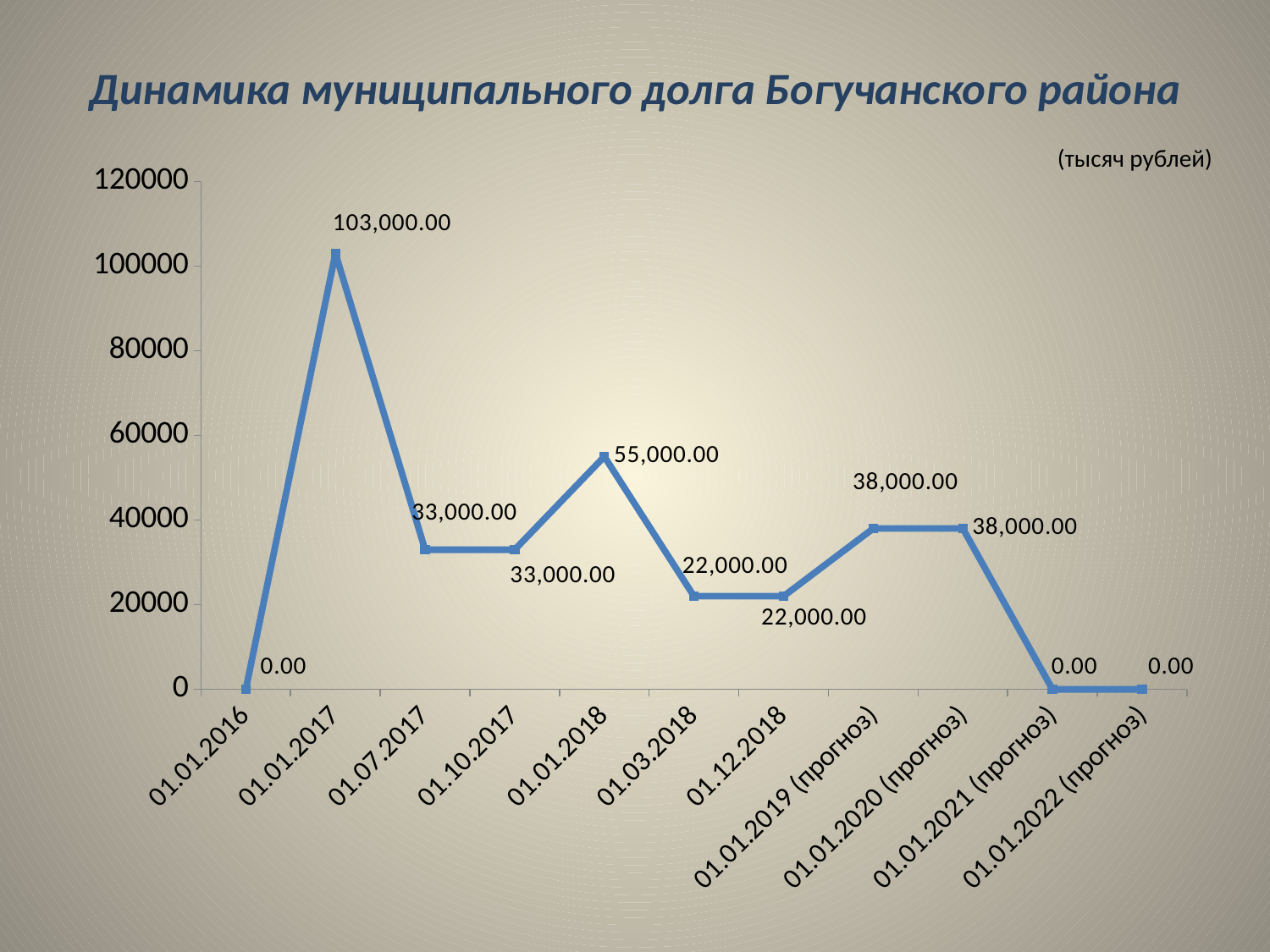
What is the difference between the values for 01.01.2019 (прогноз) and 01.12.2018? 16,000.00 What is the value for 01.01.2018? 55,000.00 Is the value for 01.01.2017 greater or less than 100000? greater What is the value for 01.03.2018? 22,000.00 What is the value for 01.01.2020 (прогноз)? 38,000.00 Which date has the highest value? 01.01.2017 Which is larger, the value for 01.07.2017 or the value for 01.01.2018? 01.01.2018 What is the value for 01.01.2017? 103,000.00 How many dates are shown on the x axis? 11 What is the difference between the values for 01.01.2017 and 01.01.2018? 48,000.00 What is the title of the chart? Динамика муниципального долга Богучанского района What kind of chart is shown on the slide? line chart